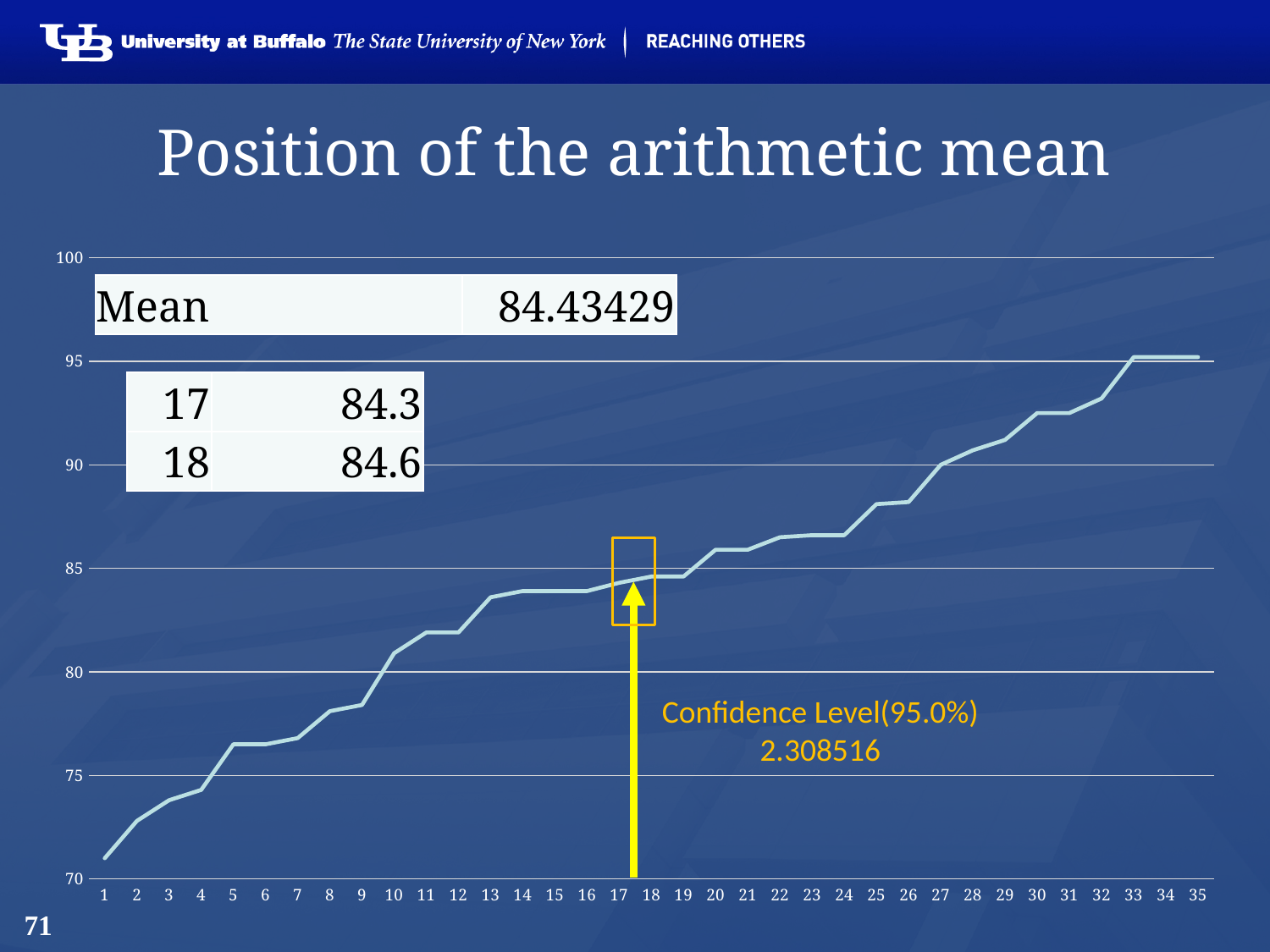
How many points are plotted along the x axis? 35 What is the value shown for position 17? 84.3 What mean value is printed on the slide? 84.43429 Which has the larger value, position 17 or position 18? 18 Is the value for position 1 greater or less than 75? less Is the value for position 30 greater or less than 90? greater What kind of chart is shown on the slide? line chart Which position has the lowest value on the chart? 1 Do the plotted values rise or fall as the x axis goes from 1 to 35? rise What is the difference between the values at positions 18 and 17? 0.3 What is the Confidence Level(95.0%) value printed on the chart? 2.308516 What is the value shown for position 18? 84.6